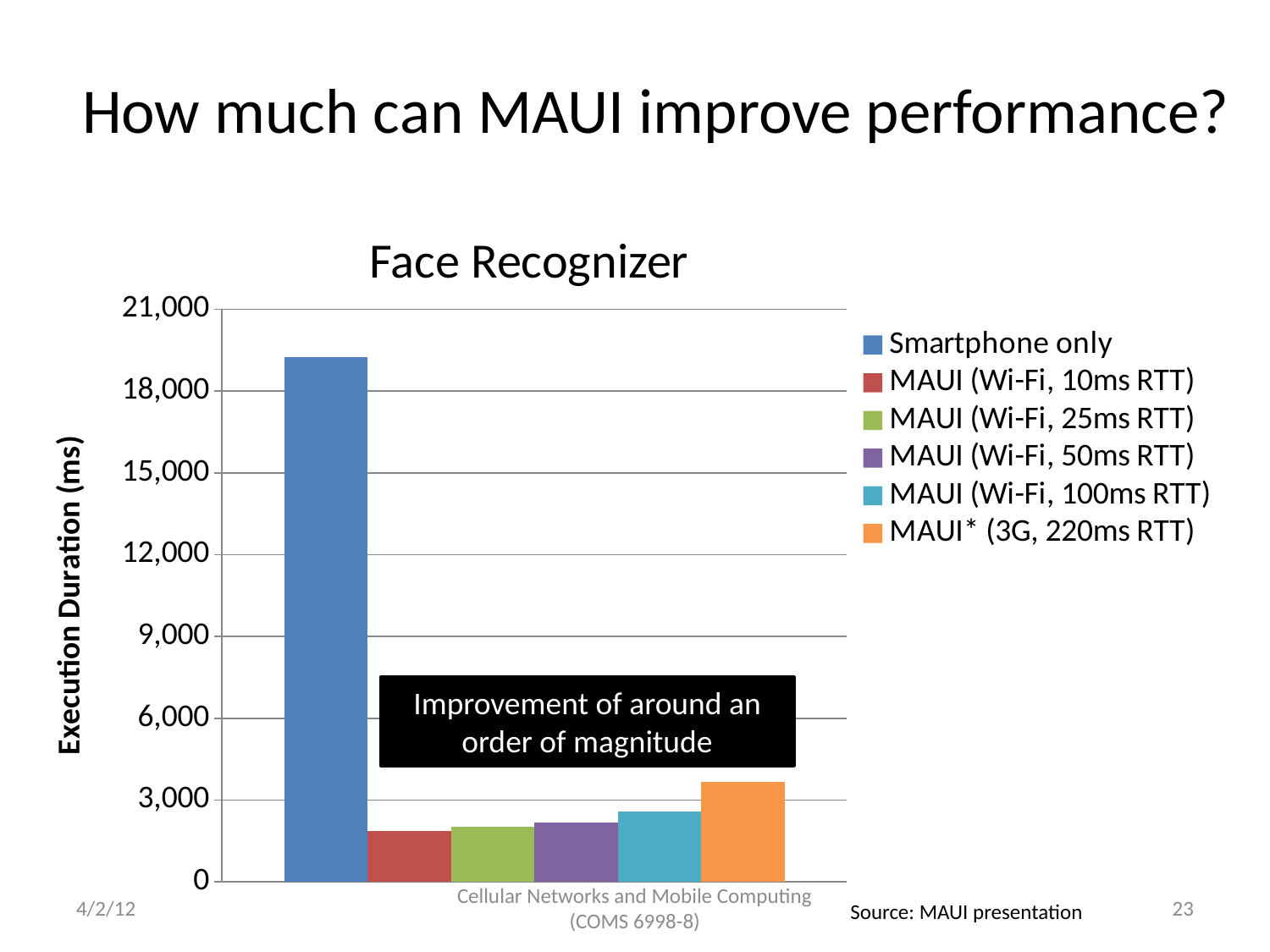
Is the execution duration for MAUI (Wi-Fi, 10ms RTT) greater or less than 3,000? less How many series does the chart's legend list? 6 Across the MAUI bars from left to right (10ms RTT to 3G 220ms RTT), do the execution durations rise or fall? rise Is the execution duration for Smartphone only greater or less than 18,000? greater Is the execution duration for MAUI (Wi-Fi, 100ms RTT) greater or less than 3,000? less What is the title of the chart? Face Recognizer Which has a larger execution duration, Smartphone only or MAUI* (3G, 220ms RTT)? Smartphone only Which series has the highest execution duration? Smartphone only What type of chart is shown on the slide? bar chart Which has a larger execution duration, MAUI* (3G, 220ms RTT) or MAUI (Wi-Fi, 100ms RTT)? MAUI* (3G, 220ms RTT) What is the label of the vertical axis? Execution Duration (ms)